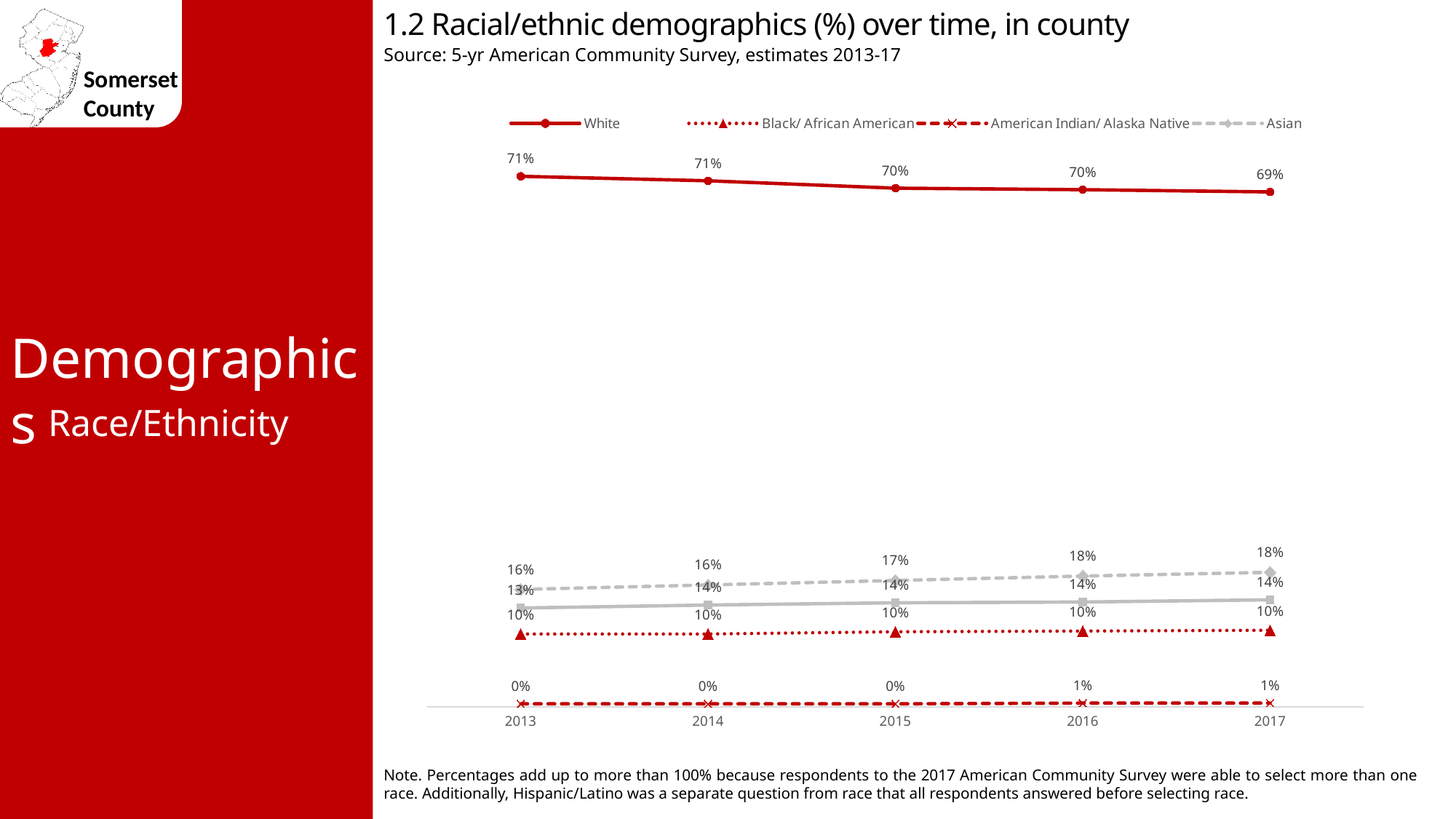
What percentage is shown for Black/ African American in 2015? 10% Which racial/ethnic group has the lowest percentage in 2013? American Indian/ Alaska Native Does the White percentage rise or fall from 2013 to 2017? Fall Which racial/ethnic group has the highest percentage in 2017? White What percentage is shown for White in 2013? 71% What percentage is shown for Asian in 2017? 18% By how many percentage points did the White share change from 2013 to 2017? 2 percentage points How many years are shown on the x axis? 5 What percentage is shown for American Indian/ Alaska Native in 2016? 1% What kind of chart is shown on the slide? Line chart What percentage is shown for White in 2017? 69% In 2017, which is larger: the Asian share or the Black/ African American share? Asian